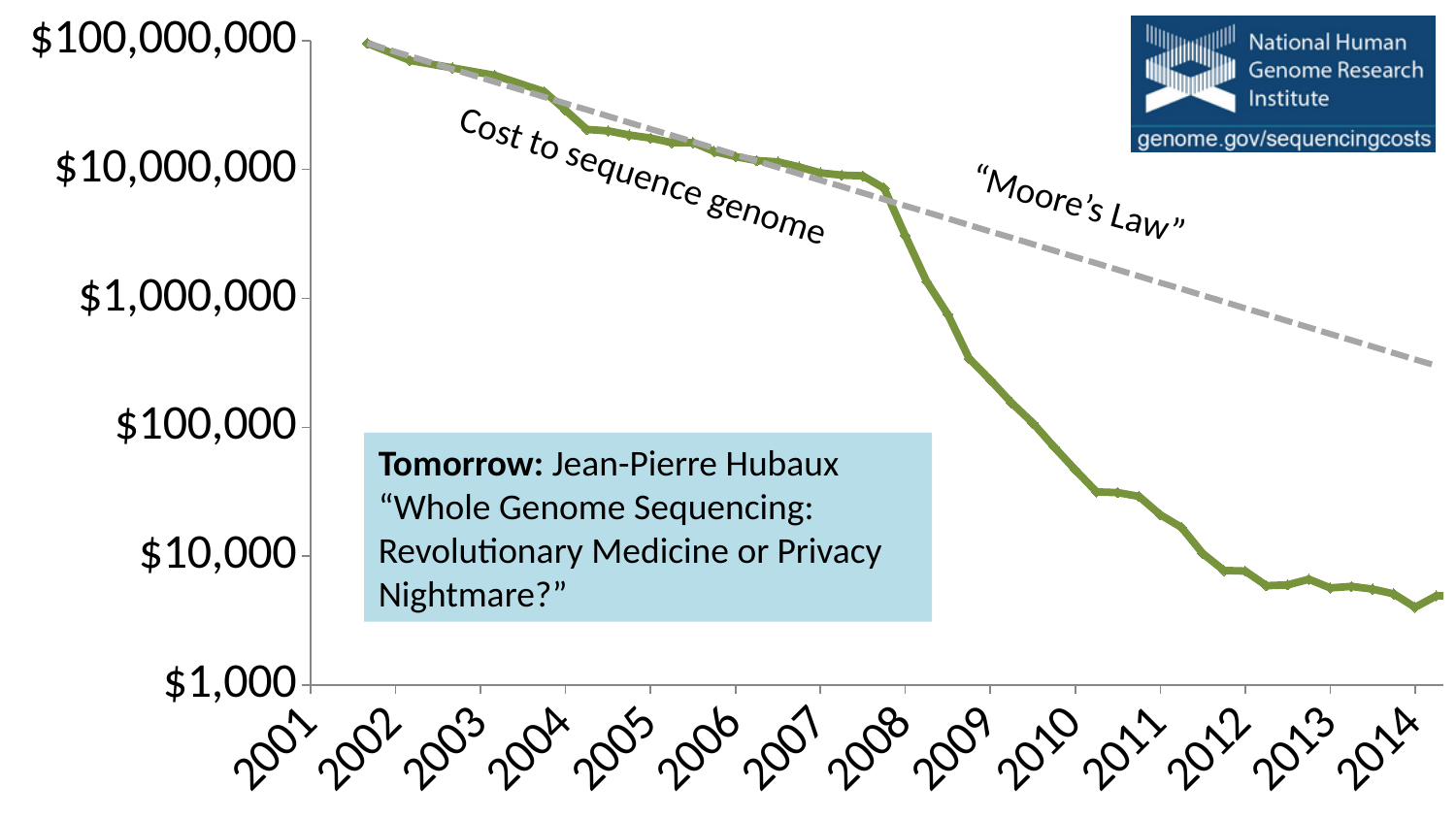
Is the cost to sequence a genome in 2014 greater or less than $10,000? less What is the label of the solid green line? Cost to sequence genome Which year has a higher cost to sequence a genome, 2004 or 2010? 2004 Does the cost to sequence a genome rise or fall from 2002 to 2014? fall How many years are labeled on the x axis? 14 How many lines are plotted on the chart? 2 Is the cost to sequence a genome in 2012 greater or less than $100,000? less What is the label of the dashed grey line? "Moore's Law" What kind of chart is shown on the slide? line chart Which is higher in 2012, the cost to sequence a genome or the Moore's Law line? Moore's Law Is the cost to sequence a genome in 2002 greater or less than $10,000,000? greater